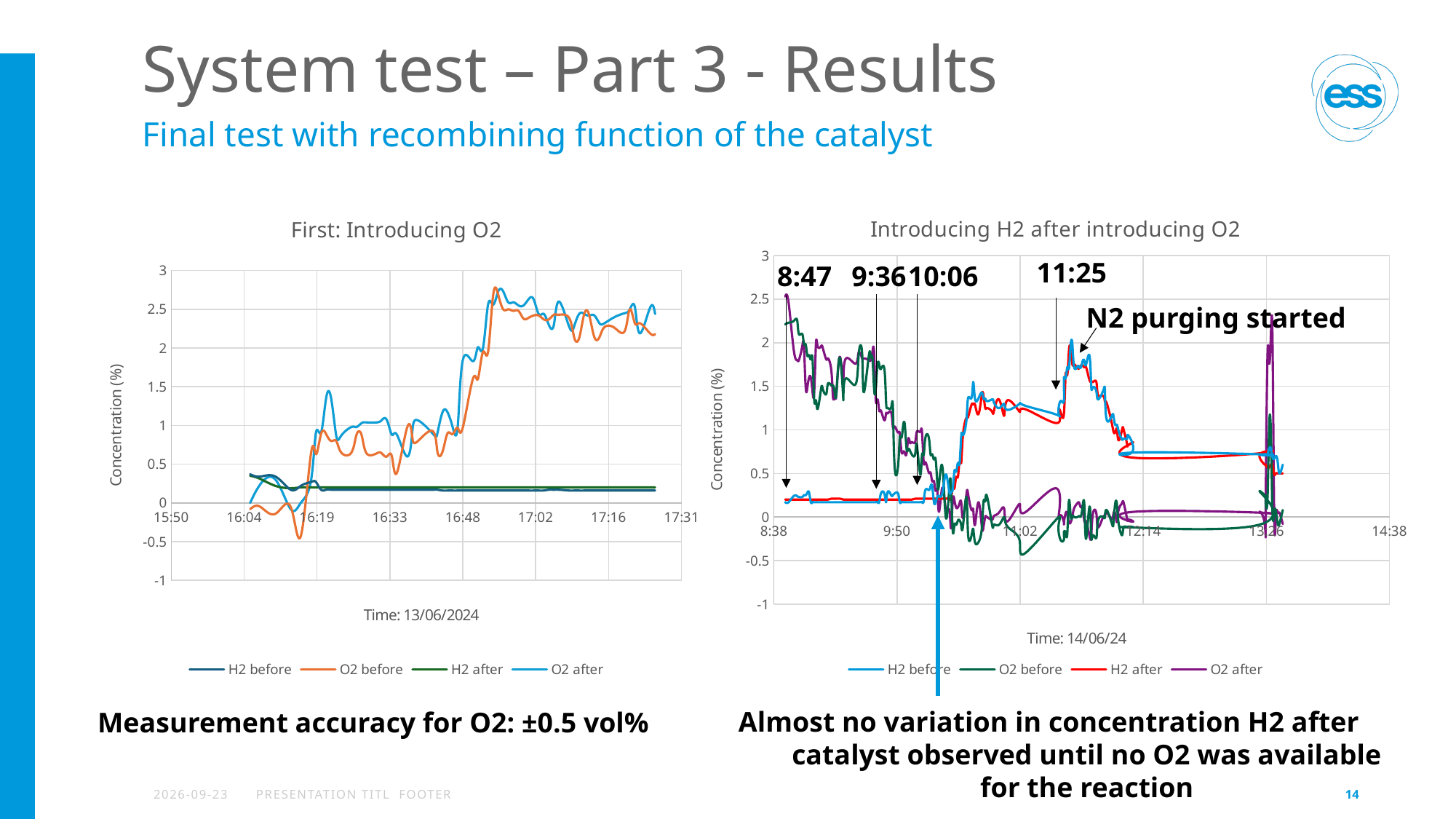
In the left chart ("First: Introducing O2"), is the value of the H2 after series at 16:48 greater or less than 0.5? less What kind of chart is the chart titled "First: Introducing O2"? line chart In the left chart ("First: Introducing O2"), does the O2 before series overall rise or fall between 16:04 and 17:16? rise What is the y-axis title of the left chart ("First: Introducing O2")? Concentration (%) What kind of chart is the chart titled "Introducing H2 after introducing O2"? line chart In the right chart ("Introducing H2 after introducing O2"), is the value of the O2 after series at 8:38 greater or less than 2? greater How many series does the legend of the right chart ("Introducing H2 after introducing O2") list? 4 In the right chart ("Introducing H2 after introducing O2"), is the value of the H2 before series at 9:50 greater or less than 0.5? less What is the x-axis title of the right chart ("Introducing H2 after introducing O2")? Time: 14/06/24 How many series does the legend of the left chart ("First: Introducing O2") list? 4 In the right chart ("Introducing H2 after introducing O2"), does the O2 before series overall rise or fall between 8:38 and 11:02? fall